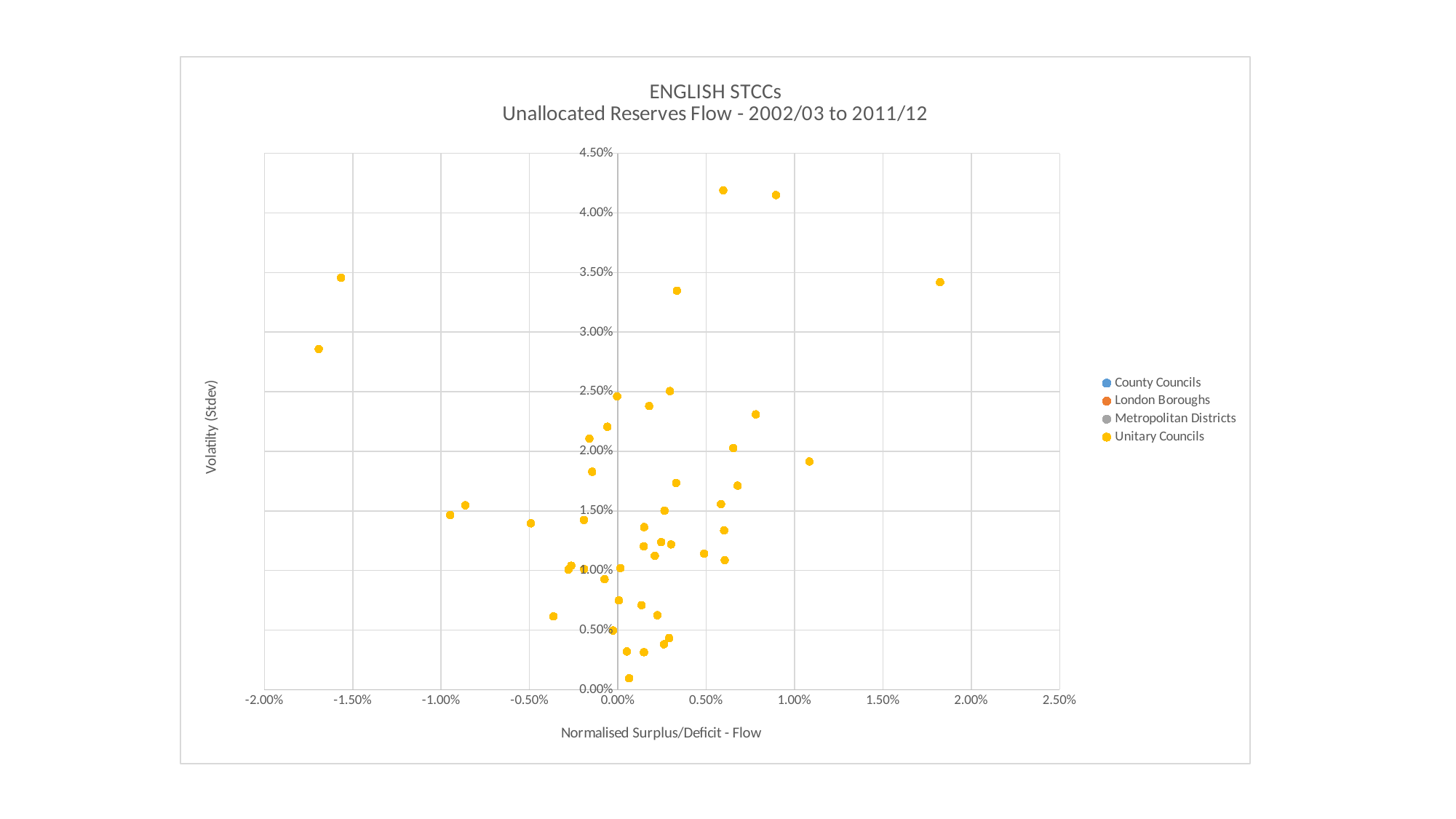
How many series does the legend list? 4 What is the highest tick value shown on the vertical axis? 4.50% Is the lowest Volatility (Stdev) value plotted greater or less than 0.50%? less Is the point with the highest Normalised Surplus/Deficit - Flow value above or below 3.00% on the Volatility (Stdev) axis? above What kind of chart is shown on the slide? scatter chart Is the highest Volatility (Stdev) value plotted greater or less than 4.00%? greater How many points are plotted to the left of -1.00% on the Normalised Surplus/Deficit - Flow axis? 2 What is the label on the vertical axis? Volatility (Stdev) What is the title of the chart? ENGLISH STCCs Unallocated Reserves Flow - 2002/03 to 2011/12 How many points are plotted above 4.00% on the Volatility (Stdev) axis? 2